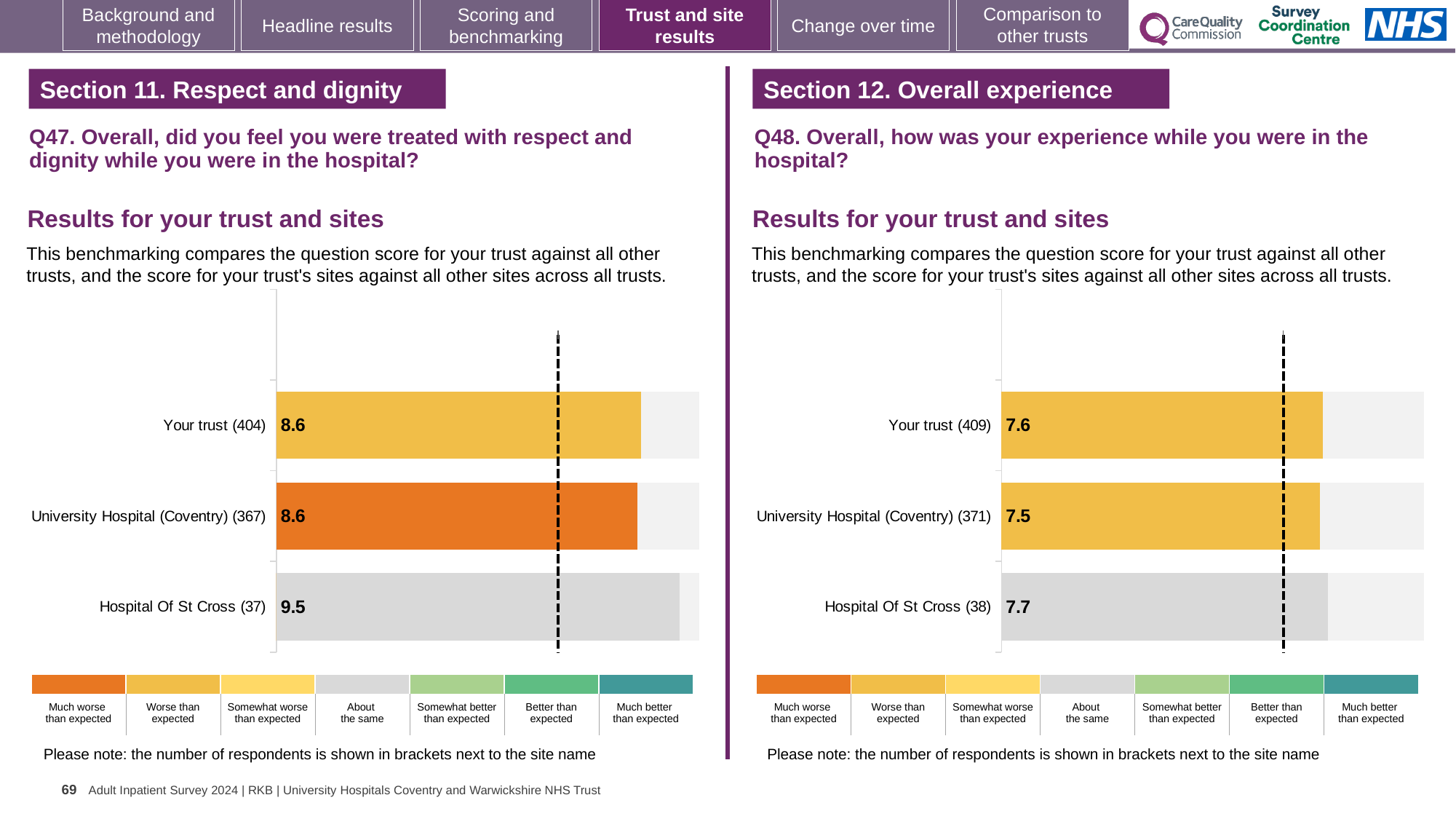
On the left chart (Q47), what is the difference between the score for Hospital Of St Cross and the score for Your trust? 0.9 On the right chart (Q48), what is the score for Your trust? 7.6 On the right chart (Q48), what is the difference between the score for Hospital Of St Cross and the score for University Hospital (Coventry)? 0.2 On the left chart (Q47), how many respondents are shown in brackets for University Hospital (Coventry)? 367 On the right chart (Q48), which site or trust has the lowest score? University Hospital (Coventry) How many bars are plotted on the left chart (Q47)? 3 What type of chart is used on the right side of the slide (Q48)? Bar chart On the left chart (Q47), which site or trust has the highest score? Hospital Of St Cross On the left chart (Q47), what is the score for Your trust? 8.6 On the right chart (Q48), which has the larger score: Your trust or Hospital Of St Cross? Hospital Of St Cross On the right chart (Q48), what is the score for University Hospital (Coventry)? 7.5 On the left chart (Q47), what is the score for Hospital Of St Cross? 9.5